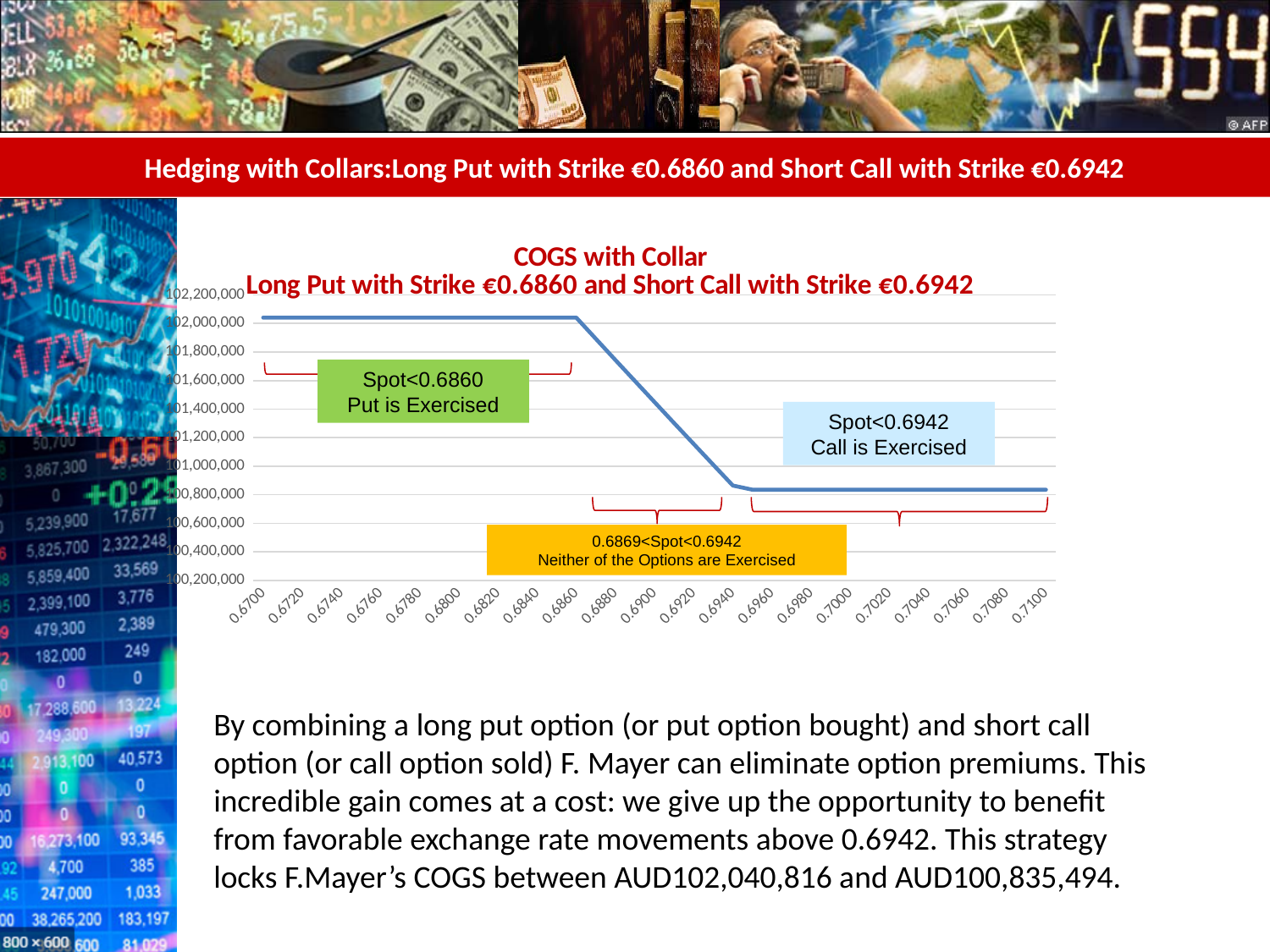
What is the lowest value labelled on the y axis? 100,200,000 What is the title of the chart? COGS with Collar Long Put with Strike €0.6860 and Short Call with Strike €0.6942 Does the COGS line rise or fall as the spot rate moves from 0.6860 to 0.6940? fall Does the COGS line rise, fall, or stay flat between spot rates 0.6960 and 0.7100? stay flat What kind of chart is shown on the slide? line chart Is the COGS value at a spot rate of 0.6920 greater or less than 101,400,000? less Is the COGS value at a spot rate of 0.7100 greater or less than 101,000,000? less Is COGS higher at a spot rate of 0.6880 or at 0.6940? 0.6880 Is the COGS value at a spot rate of 0.6800 greater or less than 101,600,000? greater How many spot-rate tick labels are shown along the x axis? 21 Is COGS higher at a spot rate of 0.6700 or at 0.7100? 0.6700